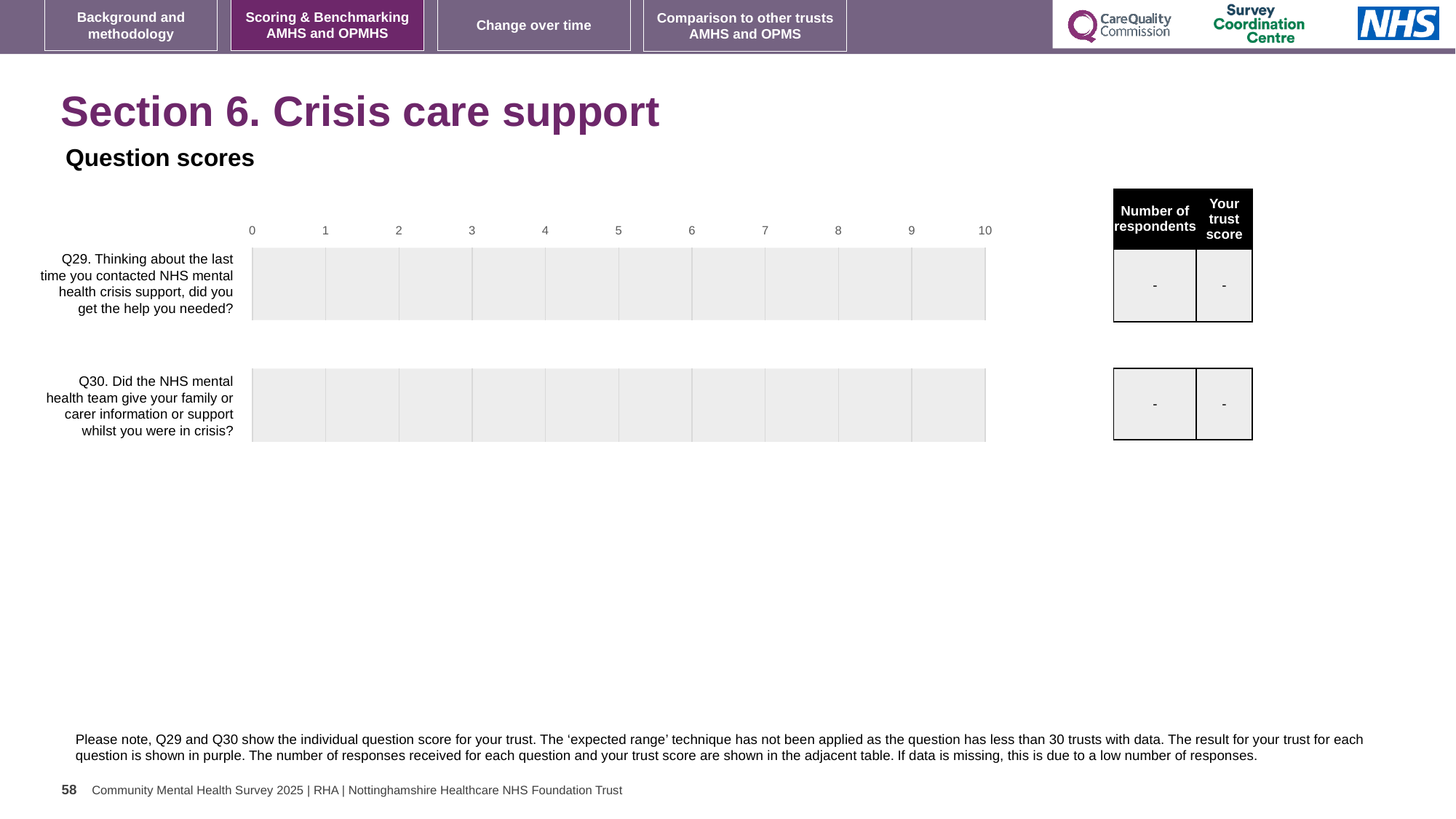
What is the highest value shown on the chart's horizontal axis? 10 What value is shown in the 'Your trust score' column for Q30? - What is the lowest value shown on the chart's horizontal axis? 0 What value is shown in the 'Number of respondents' column for Q29? - What value is shown in the 'Number of respondents' column for Q30? - What value is shown in the 'Your trust score' column for Q29? - What kind of chart is shown on the slide? bar chart How many questions (categories) are listed on the chart? 2